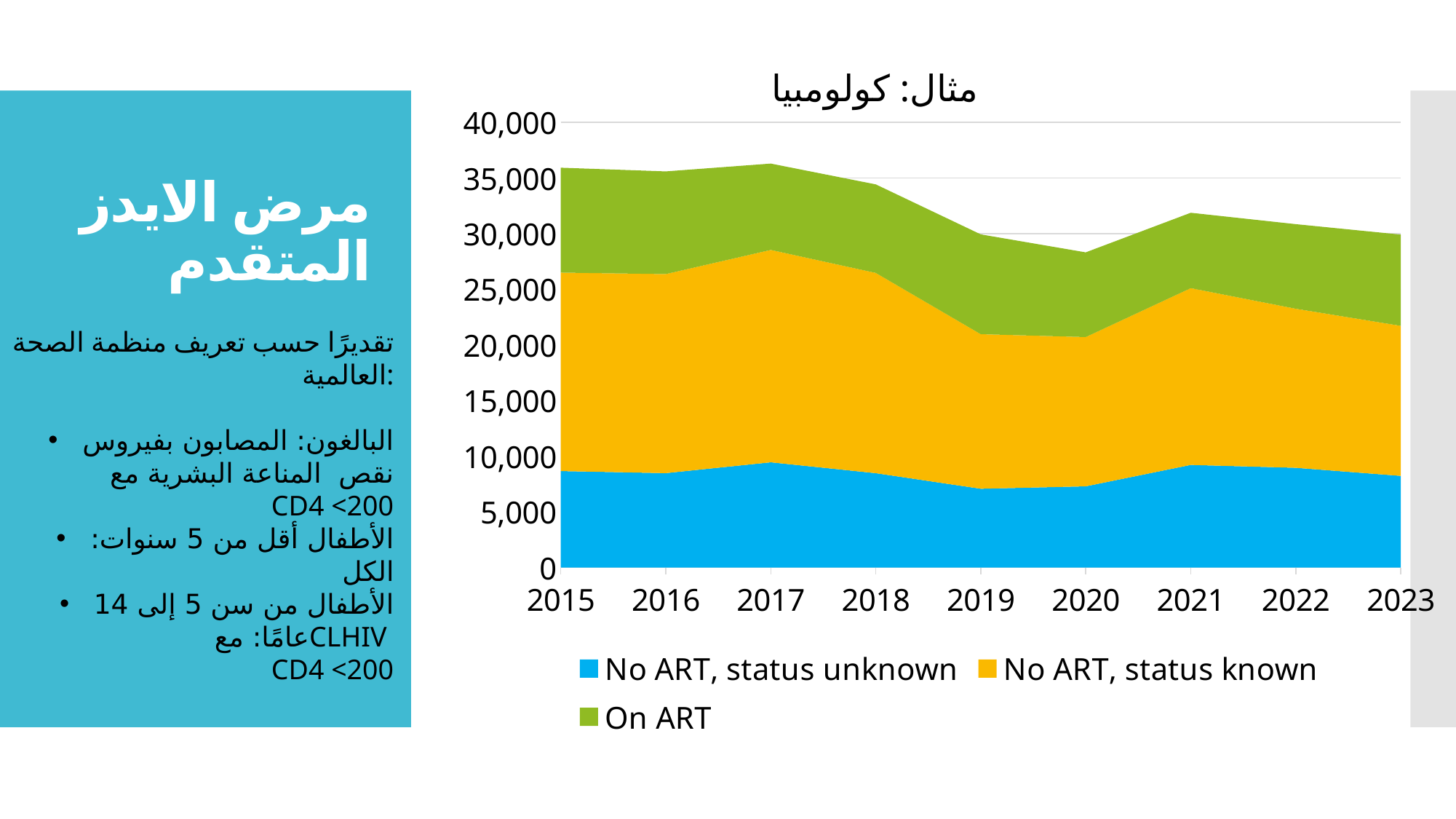
Is the value for 'No ART, status unknown' in 2019 greater or less than 10,000? less What kind of chart is shown on the slide? Stacked area chart Does the total stacked value rise or fall from 2017 to 2020? fall Which series is shown in green in the chart? On ART How many years are shown along the x axis of the chart? 9 Is the total stacked value for 2020 greater or less than 30,000? less How many series does the chart legend list? 3 Is the combined value of the two 'No ART' series in 2023 greater or less than 20,000? greater Which year has the larger total stacked value, 2015 or 2020? 2015 What is the first year shown on the x axis of the chart? 2015 In which year is the total stacked value lowest? 2020